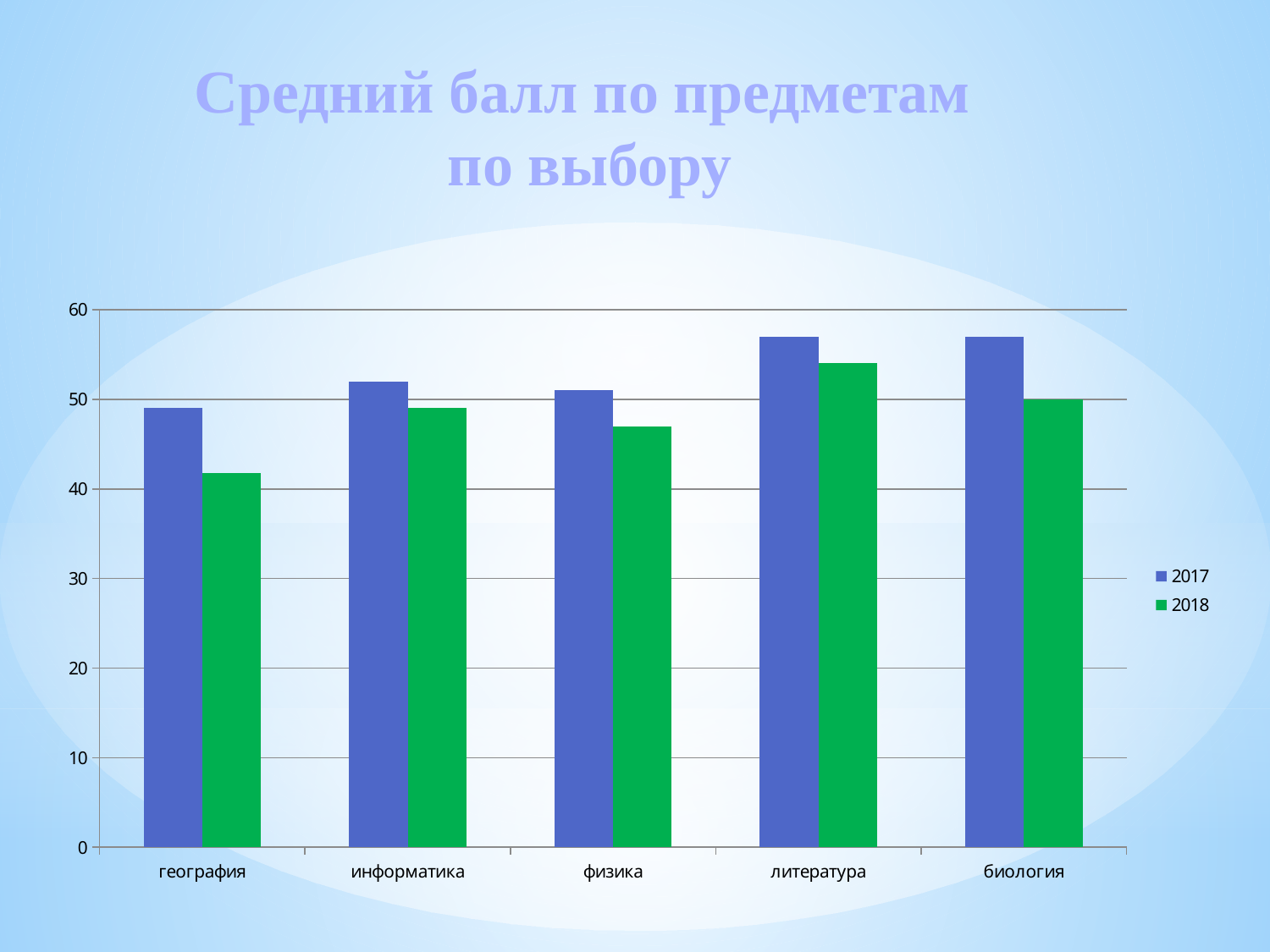
Is the 2018 value for физика greater or less than 50? less Is the 2018 value for география greater or less than 50? less For биология, which year has the larger value, 2017 or 2018? 2017 For география, which year has the larger value, 2017 or 2018? 2017 What is the title of the slide? Средний балл по предметам по выбору How many subjects (categories) are shown on the x axis? 5 Is the 2017 value for литература greater or less than 50? greater What kind of chart is shown on the slide? bar chart How many series does the legend list? 2 Which colour represents the 2018 series in the legend? green Which subject has the highest value for 2018? литература Which subject has the lowest value for 2018? география